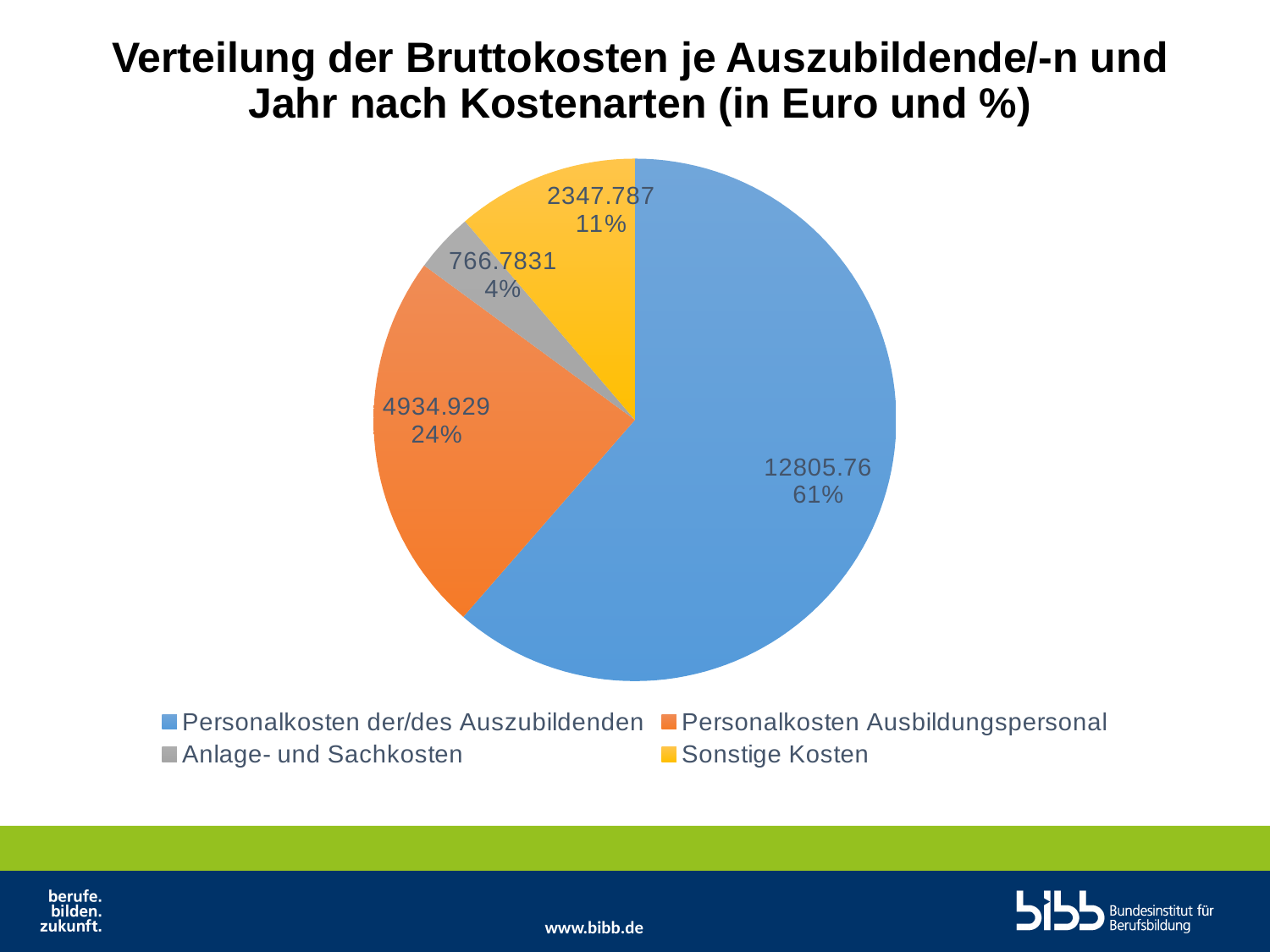
What is the value shown for Sonstige Kosten? 2347.787 What is the value shown for Personalkosten der/des Auszubildenden? 12805.76 What is the value shown for Personalkosten Ausbildungspersonal? 4934.929 Which cost category has the largest slice? Personalkosten der/des Auszubildenden How many categories does the pie chart have? 4 What is the value shown for Anlage- und Sachkosten? 766.7831 What kind of chart is shown on the slide? pie chart What share of the pie does Personalkosten der/des Auszubildenden represent? 61% What colour is the slice for Personalkosten Ausbildungspersonal? orange What share of the pie does Sonstige Kosten represent? 11% Which cost category has the smallest slice? Anlage- und Sachkosten Which is larger, Sonstige Kosten or Anlage- und Sachkosten? Sonstige Kosten